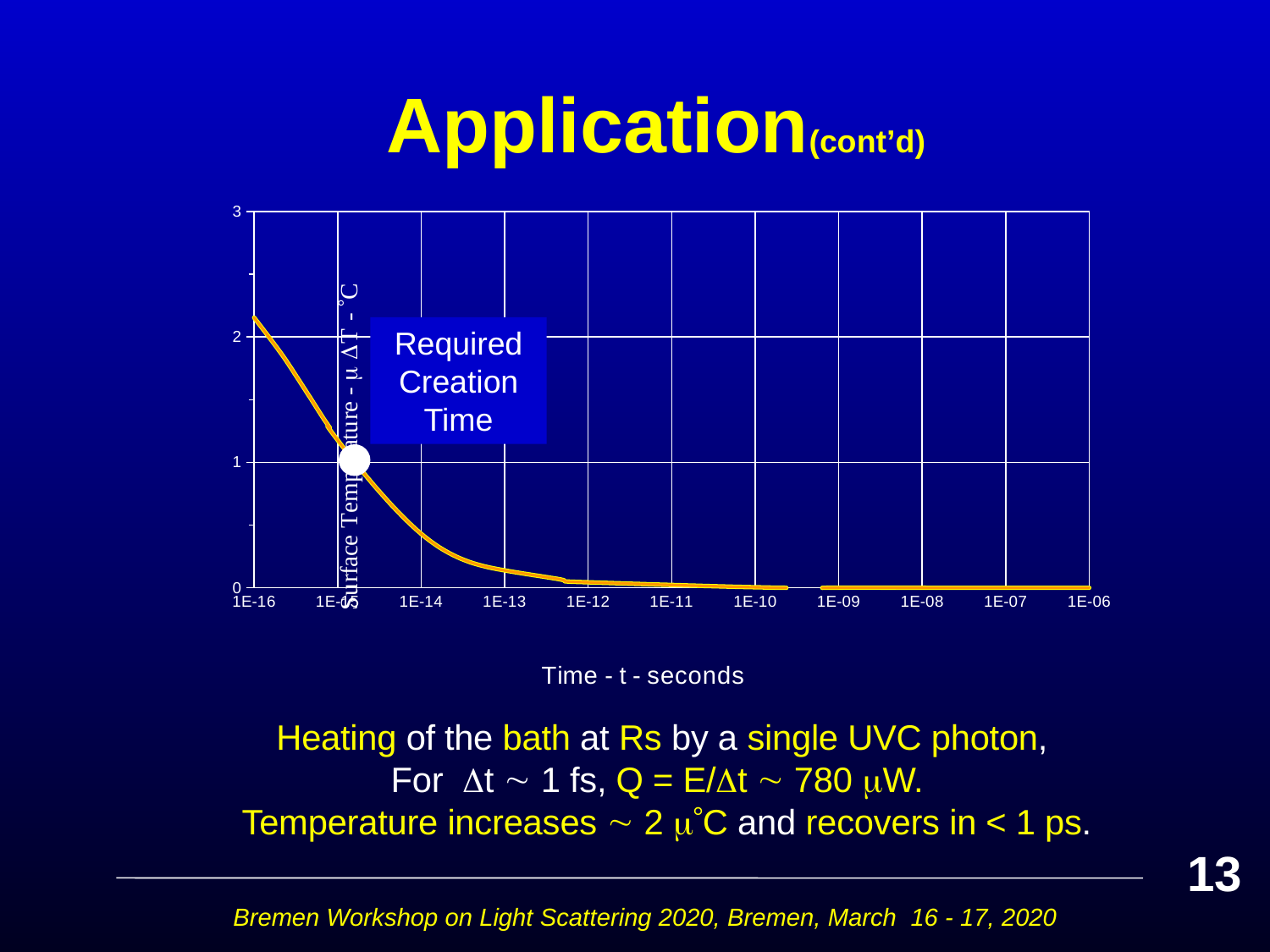
Does the surface temperature rise or fall as time increases along the x axis? fall What kind of chart is shown on the slide? line chart Which has the higher surface temperature, 1E-16 seconds or 1E-14 seconds? 1E-16 seconds Is the surface temperature at 1E-14 seconds greater or less than 1? less What text is in the annotation box pointing to the marker on the curve? Required Creation Time What is the smallest time value labelled on the x axis? 1E-16 Is the surface temperature at 1E-13 seconds greater or less than 1? less What is the highest value labelled on the y axis? 3 Is the surface temperature at 1E-12 seconds greater or less than 1? less How many tick labels are shown on the x axis? 11 What is the title of the x axis? Time - t - seconds